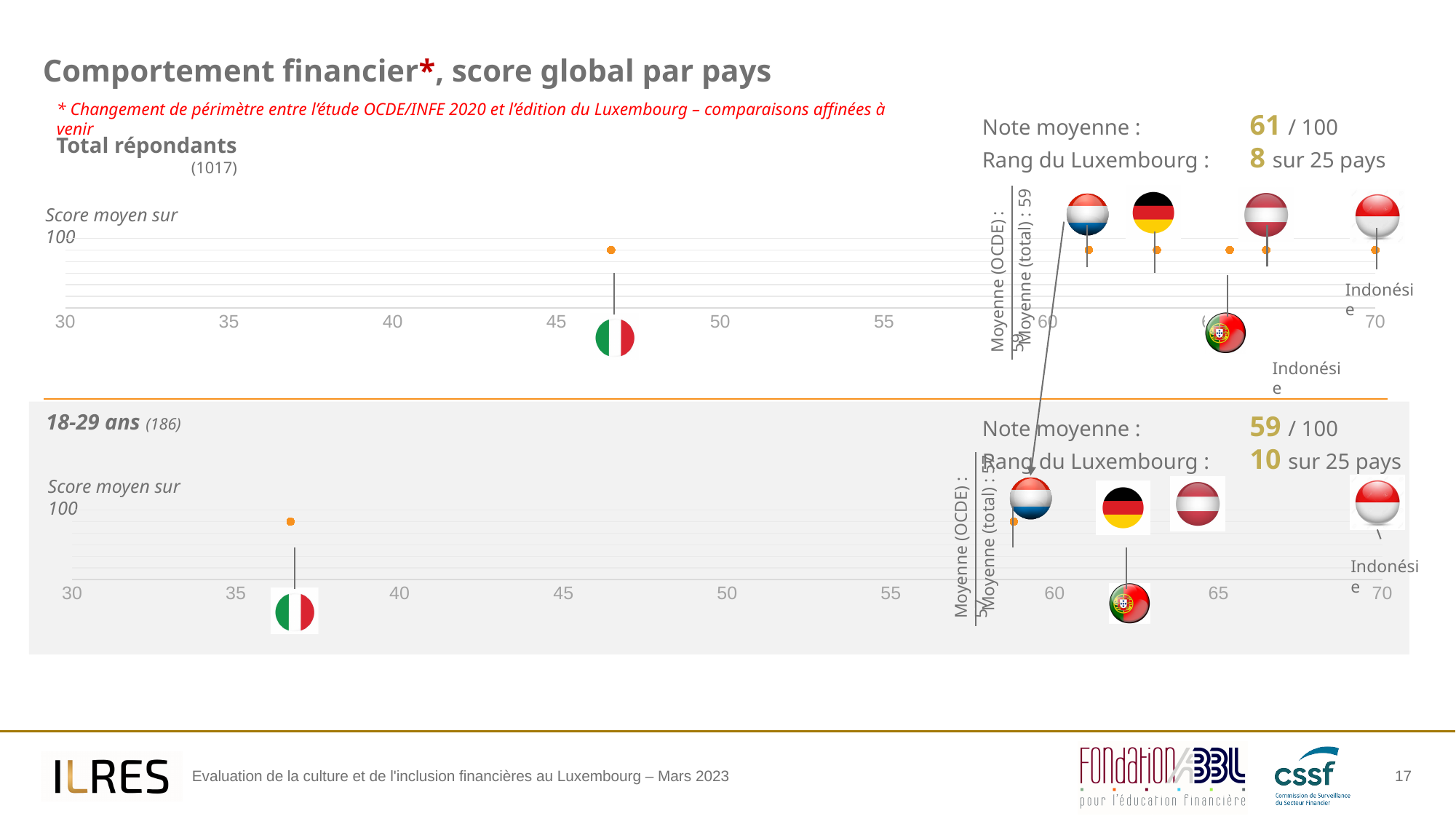
How many respondents are indicated for the '18-29 ans' chart? 186 On the 'Total répondants' chart, what value is given for 'Moyenne (OCDE)'? 59 On the 'Total répondants' chart, is the score for Indonésie greater or less than 65? greater On the '18-29 ans' chart, is the score for Italy greater or less than 40? less On the '18-29 ans' chart, which country has the highest score? Indonésie On the 'Total répondants' chart, is the score for Italy greater or less than 50? less On the '18-29 ans' chart, what is the 'Rang du Luxembourg'? 10 sur 25 pays On the 'Total répondants' chart, what is the 'Rang du Luxembourg'? 8 sur 25 pays On the 'Total répondants' chart, what is the 'Note moyenne' shown for Luxembourg? 61 / 100 On the 'Total répondants' chart, which has the higher score, Italy or Indonésie? Indonésie On the '18-29 ans' chart, what is the 'Note moyenne' shown for Luxembourg? 59 / 100 On the 'Total répondants' chart, which country has the lowest score? Italy